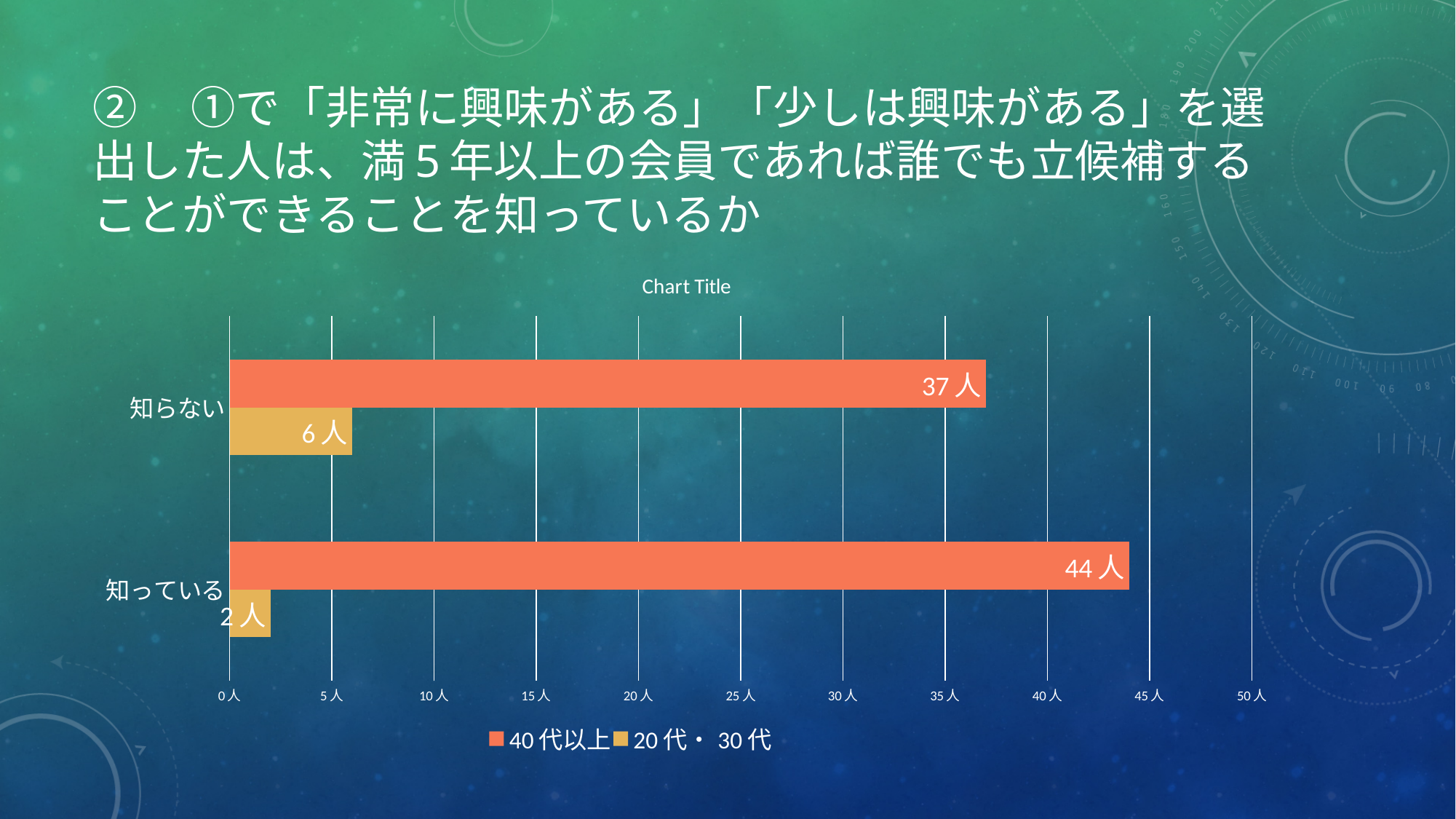
What kind of chart is shown on the slide? Bar chart What is the value for 40代以上 in the 知らない category? 37人 Which is larger: the 20代・30代 value for 知らない or for 知っている? 知らない What is the value for 20代・30代 in the 知っている category? 2人 Which category has the highest value for the 40代以上 series? 知っている What is the value for 40代以上 in the 知っている category? 44人 How many categories are shown on the chart? 2 How many series does the legend list? 2 What is the difference between the 40代以上 values for 知っている and 知らない? 7人 What is the title shown above the chart? Chart Title What is the value for 20代・30代 in the 知らない category? 6人 Which category has the lowest value for the 20代・30代 series? 知っている